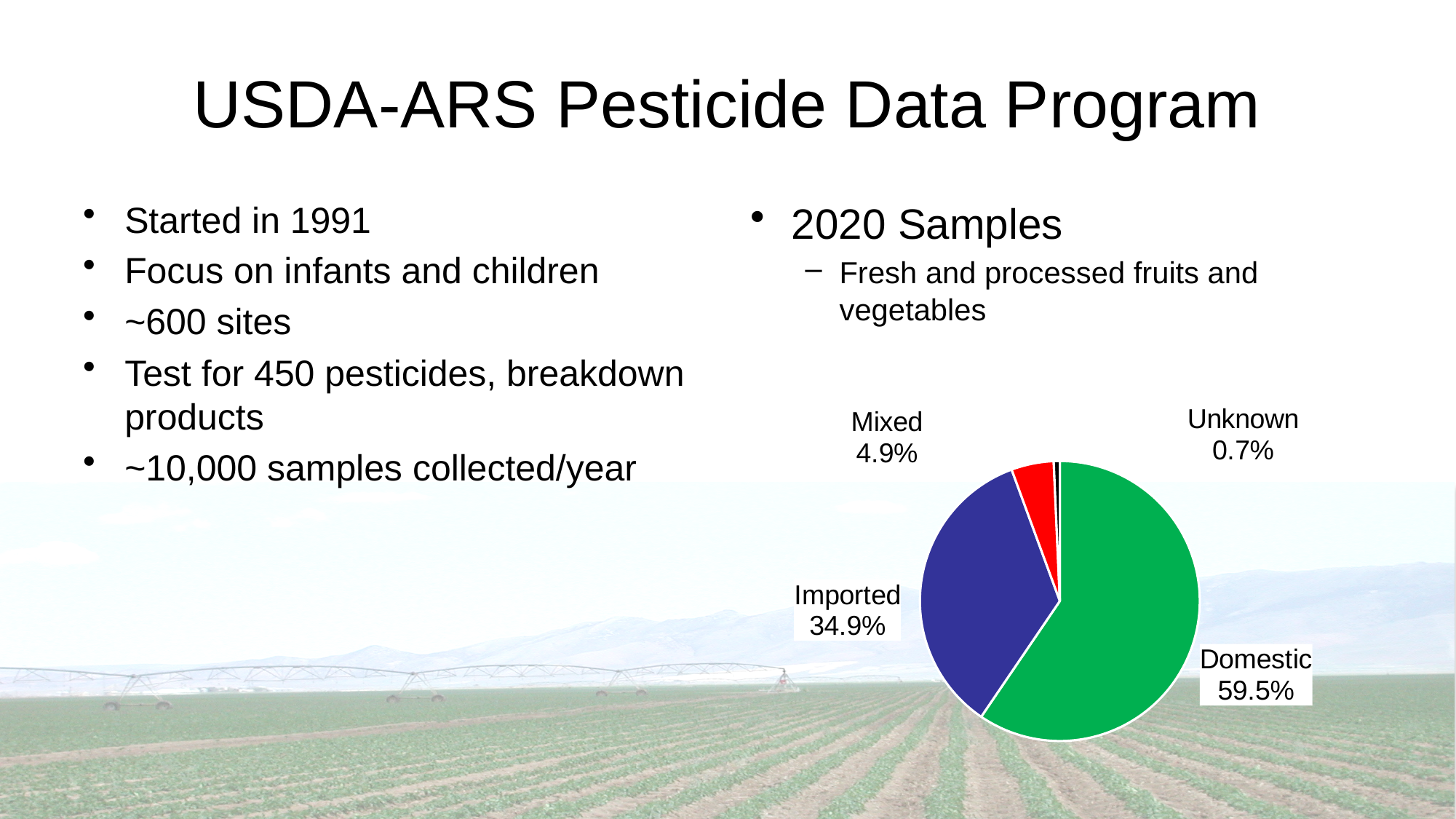
What kind of chart is shown on the slide? pie chart Which slice of the pie is the smallest? Unknown Which is larger, the Mixed slice or the Unknown slice? Mixed What share of the pie does Mixed account for? 4.9% What is the difference in percentage points between the Domestic and Imported slices? 24.6 What colour is the Domestic slice of the pie? green Which slice of the pie is the largest? Domestic What share of the pie does Imported account for? 34.9% What colour is the Imported slice of the pie? blue What share of the pie does Domestic account for? 59.5% How many slices does the pie chart have? 4 What share of the pie does Unknown account for? 0.7%